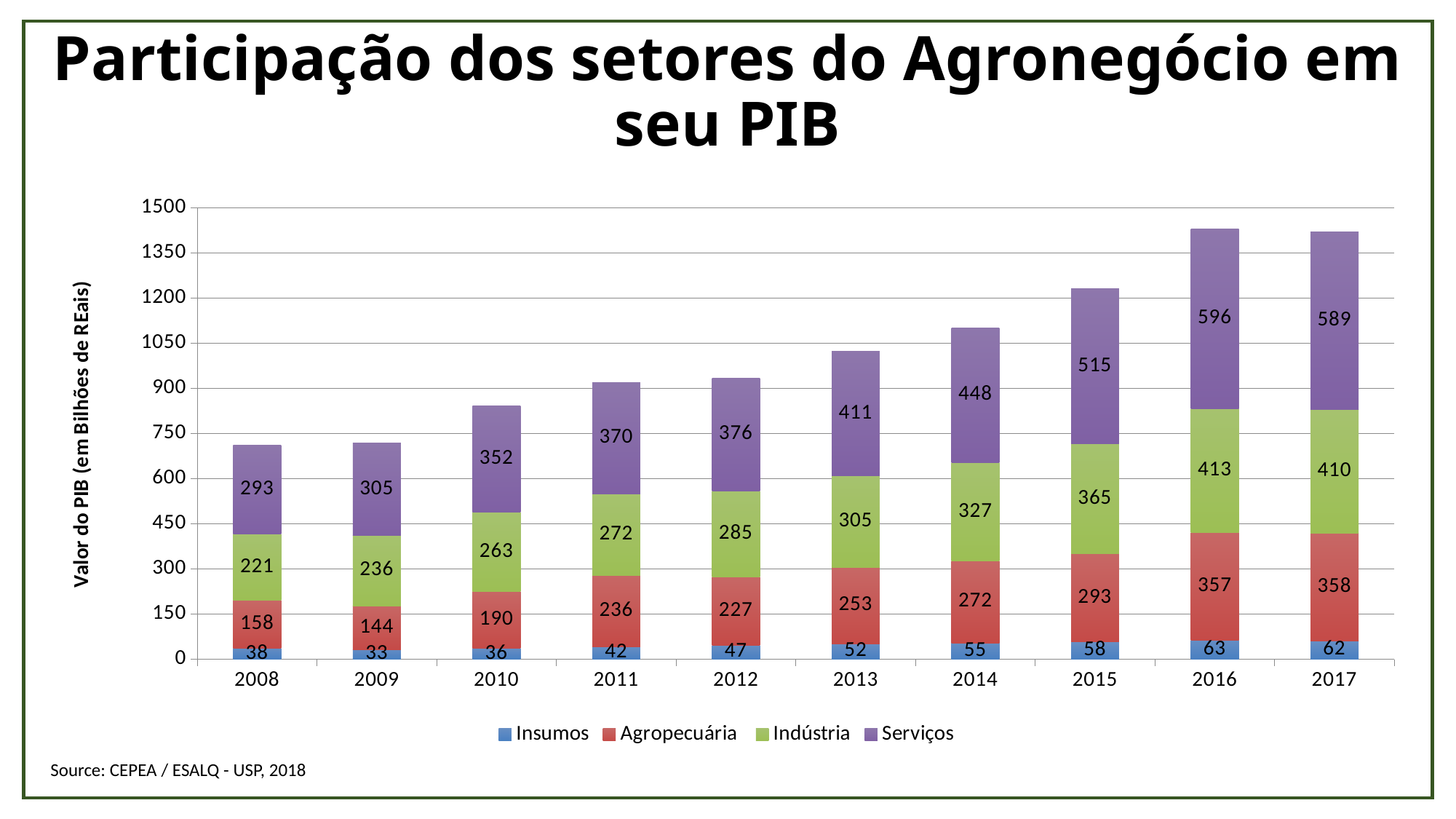
How many series does the legend list? 4 What is the value for Insumos in 2009? 33 What kind of chart is shown on the slide? Stacked bar chart What is the total of the stacked bar for 2008? 710 Which is larger, the Indústria value in 2016 or in 2017? 2016 What is the difference between the Serviços value in 2016 and in 2008? 303 In which year is the Insumos value lowest? 2009 What is the total of the stacked bar for 2017? 1419 What is the value for Agropecuária in 2013? 253 In which year is the Serviços value highest? 2016 What is the value for Serviços in 2016? 596 How many years are shown on the x axis? 10